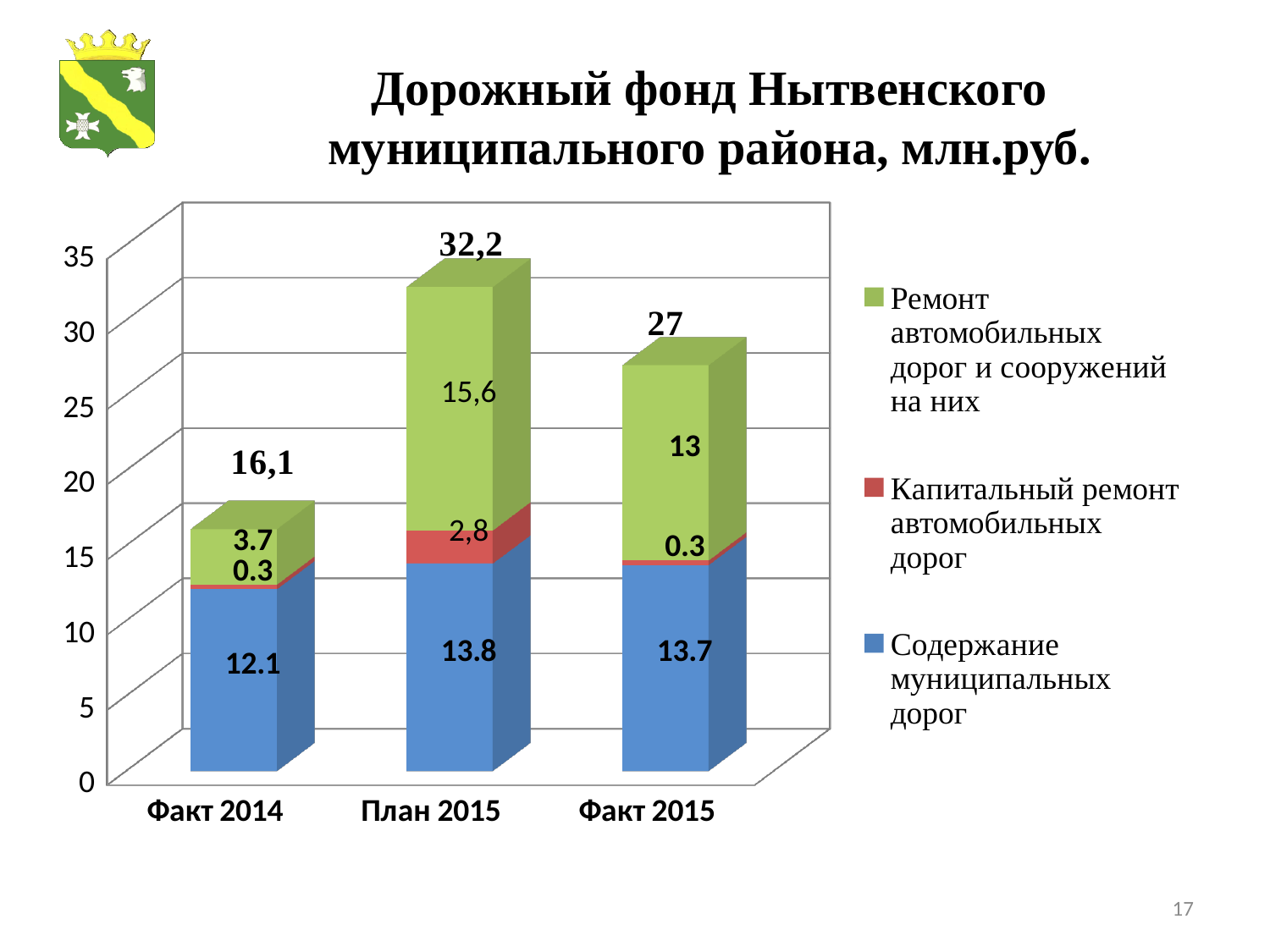
Which category has the highest total? План 2015 What kind of chart is shown on the slide? Stacked bar chart What is the difference between the Ремонт автомобильных дорог и сооружений на них values for План 2015 and Факт 2015? 2,6 What is the total shown above the План 2015 bar? 32,2 How many series does the legend list? 3 Which category has the lowest total? Факт 2014 What is the total shown above the Факт 2015 bar? 27 How many categories are shown on the x axis? 3 What is the value for Капитальный ремонт автомобильных дорог in План 2015? 2,8 What is the value for Содержание муниципальных дорог in Факт 2014? 12.1 What is the value for Ремонт автомобильных дорог и сооружений на них in План 2015? 15,6 Which is larger: the Содержание муниципальных дорог value for Факт 2014 or for Факт 2015? Факт 2015